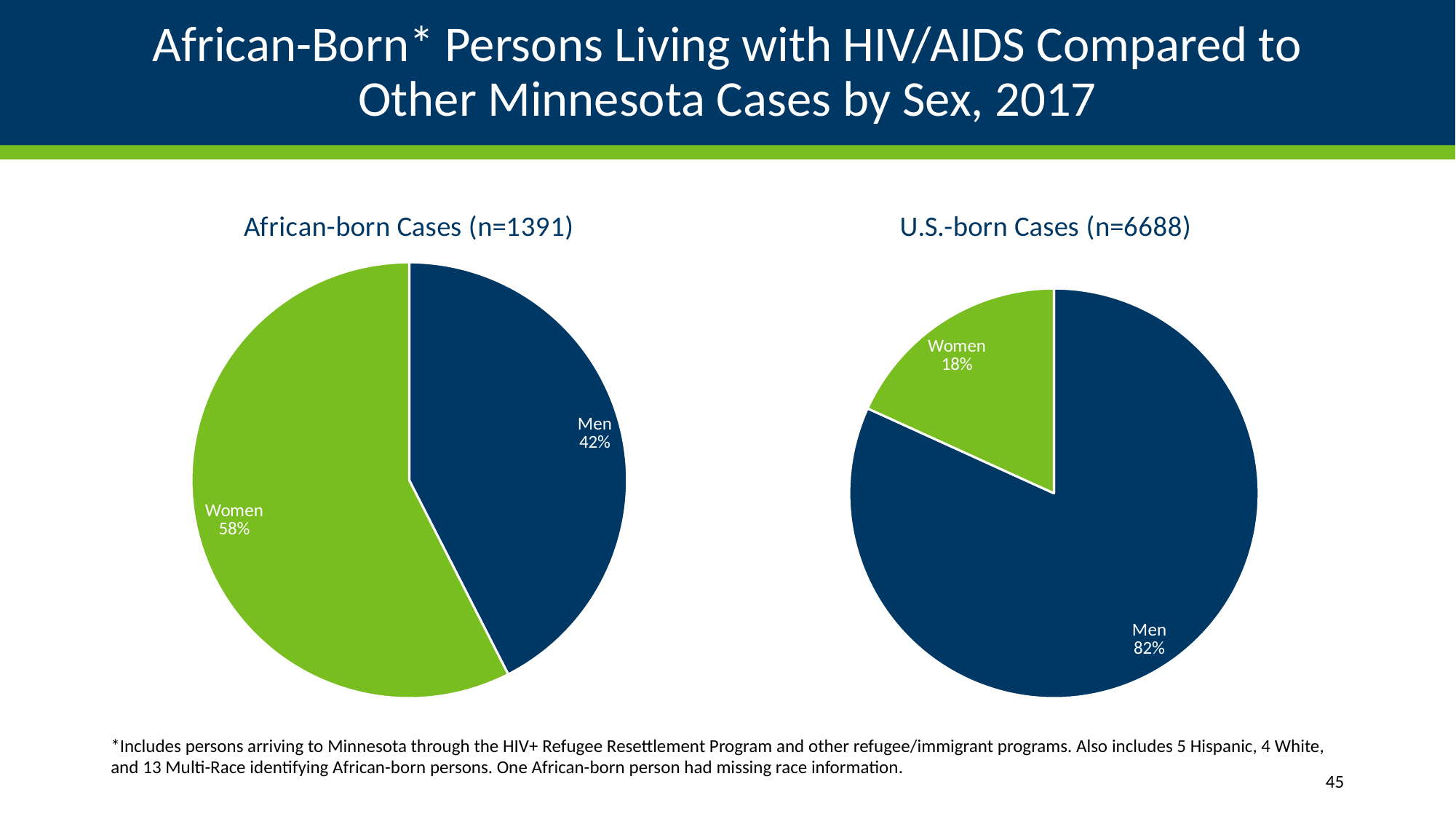
In the African-born Cases pie chart, what share of cases are women? 58% In the African-born Cases pie chart, which slice is the largest? Women In the U.S.-born Cases pie chart, what share of cases are men? 82% In the U.S.-born Cases pie chart, what share of cases are women? 18% Which is larger: the share of women among African-born cases or the share of women among U.S.-born cases? African-born cases In the African-born Cases pie chart, what share of cases are men? 42% What type of chart is used for the African-born Cases? Pie chart In the U.S.-born Cases pie chart, what is the difference in percentage points between men and women? 64 In the African-born Cases pie chart, what is the difference in percentage points between women and men? 16 How many slices does the U.S.-born Cases pie chart have? 2 What is the total number of cases (n) shown in the title of the U.S.-born Cases chart? 6688 In the U.S.-born Cases pie chart, which slice is the smallest? Women